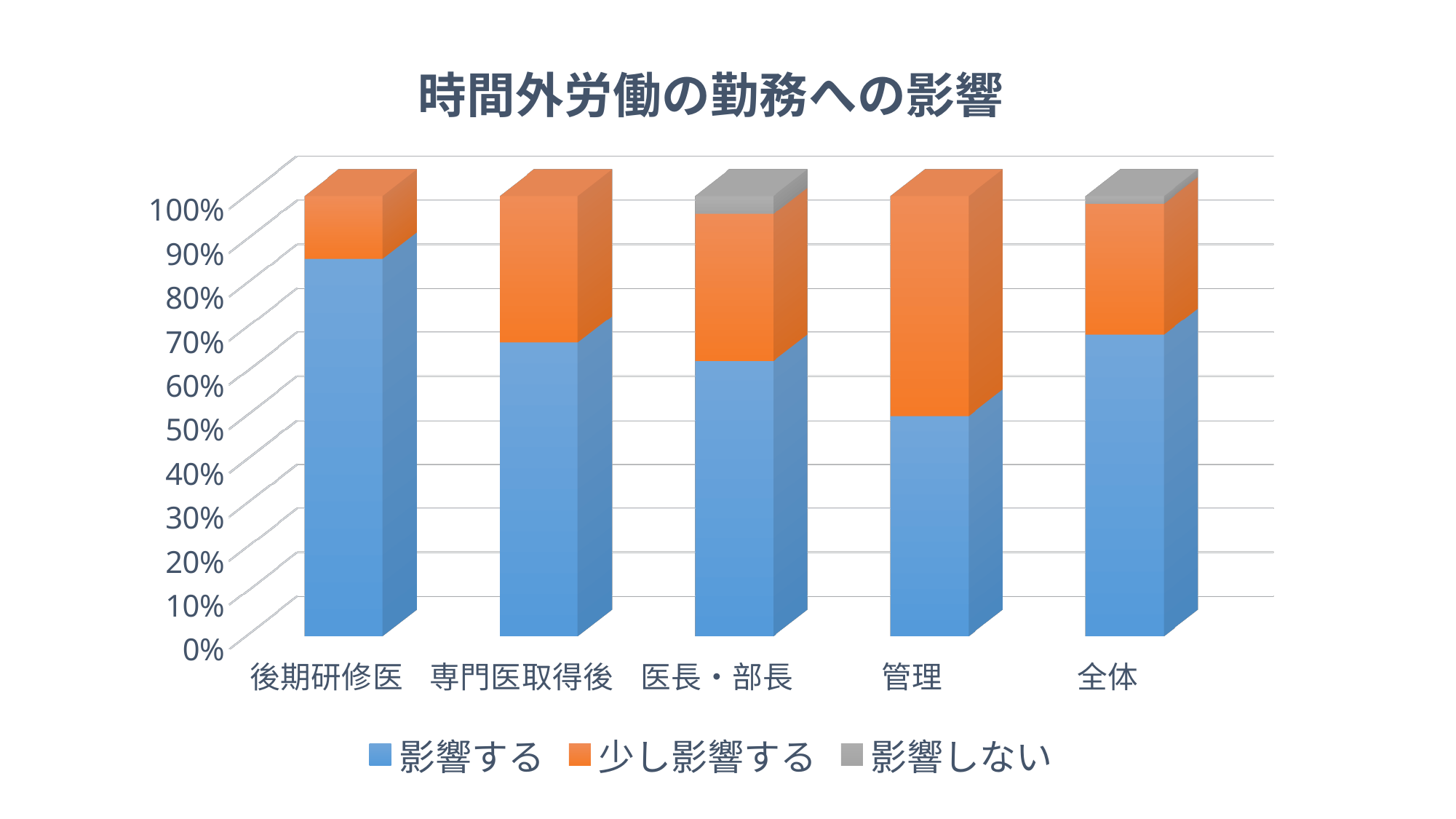
Which is larger, the 影響する share for 後期研修医 or for 管理? 後期研修医 How many categories are shown on the x axis? 5 What is the title of the chart? 時間外労働の勤務への影響 Which category has the lowest share of 影響する? 管理 Which category has the largest 少し影響する segment? 管理 Which colour represents 影響しない in the legend? Gray How many series does the legend list? 3 What kind of chart is shown on the slide? Stacked bar chart Which category has the highest share of 影響する? 後期研修医 Is the 影響する share for 管理 greater or less than 60%? less Is the 影響する share for 専門医取得後 greater or less than 60%? greater Is the 影響する share for 後期研修医 greater or less than 80%? greater